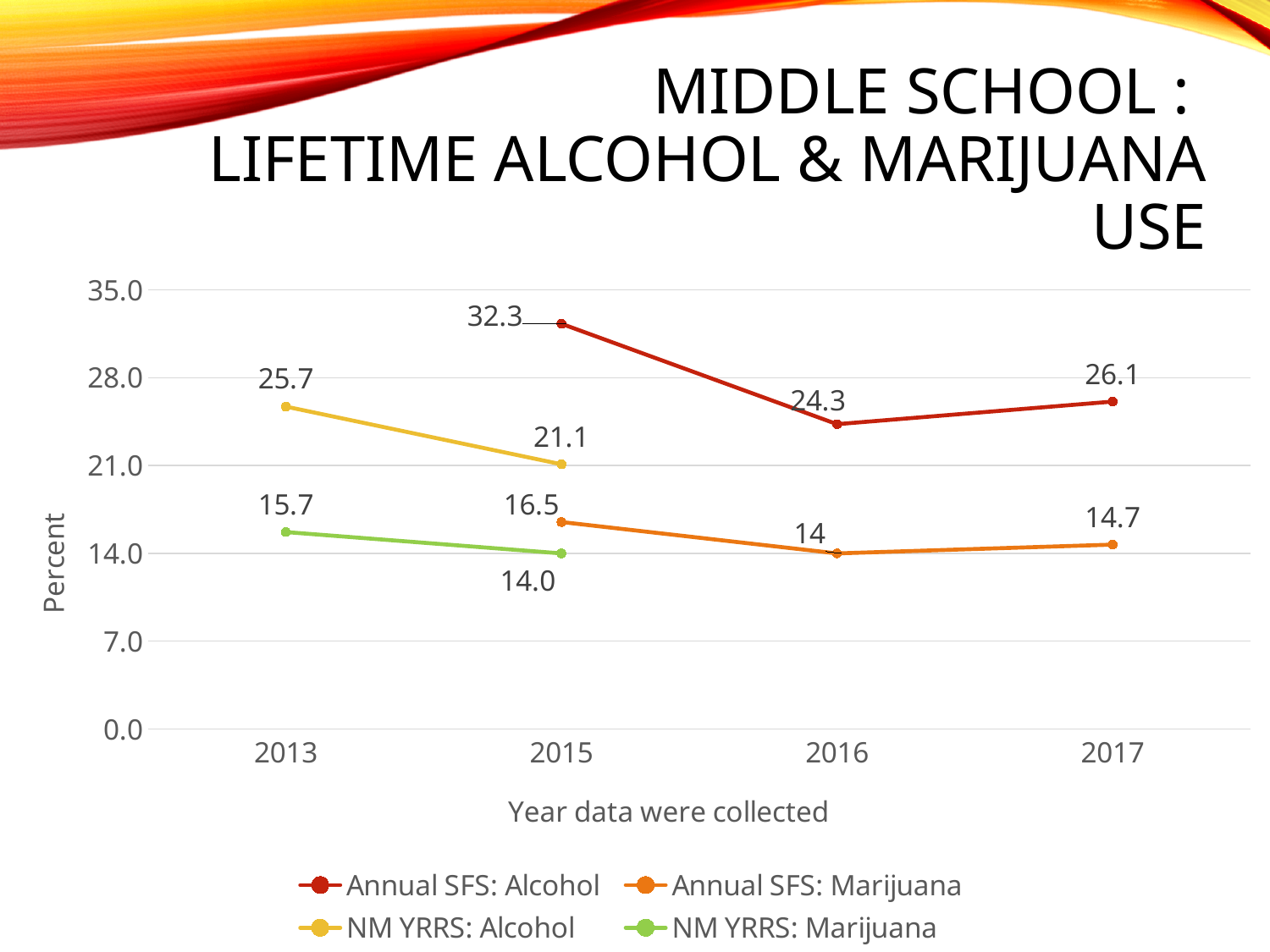
What is the value for NM YRRS: Alcohol in 2013? 25.7 How many series does the legend list? 4 Does the NM YRRS: Alcohol series rise or fall from 2013 to 2015? fall What is the value for NM YRRS: Marijuana in 2015? 14.0 What is the value for Annual SFS: Alcohol in 2015? 32.3 What is the value for Annual SFS: Marijuana in 2017? 14.7 Which is larger, the NM YRRS: Alcohol value in 2013 or the Annual SFS: Alcohol value in 2017? Annual SFS: Alcohol in 2017 What type of chart is shown on the slide? line chart How many years are shown on the x axis? 4 In which year is the Annual SFS: Alcohol value highest? 2015 What is the difference between the Annual SFS: Alcohol values in 2015 and 2016? 8.0 In which year is the Annual SFS: Marijuana value lowest? 2016